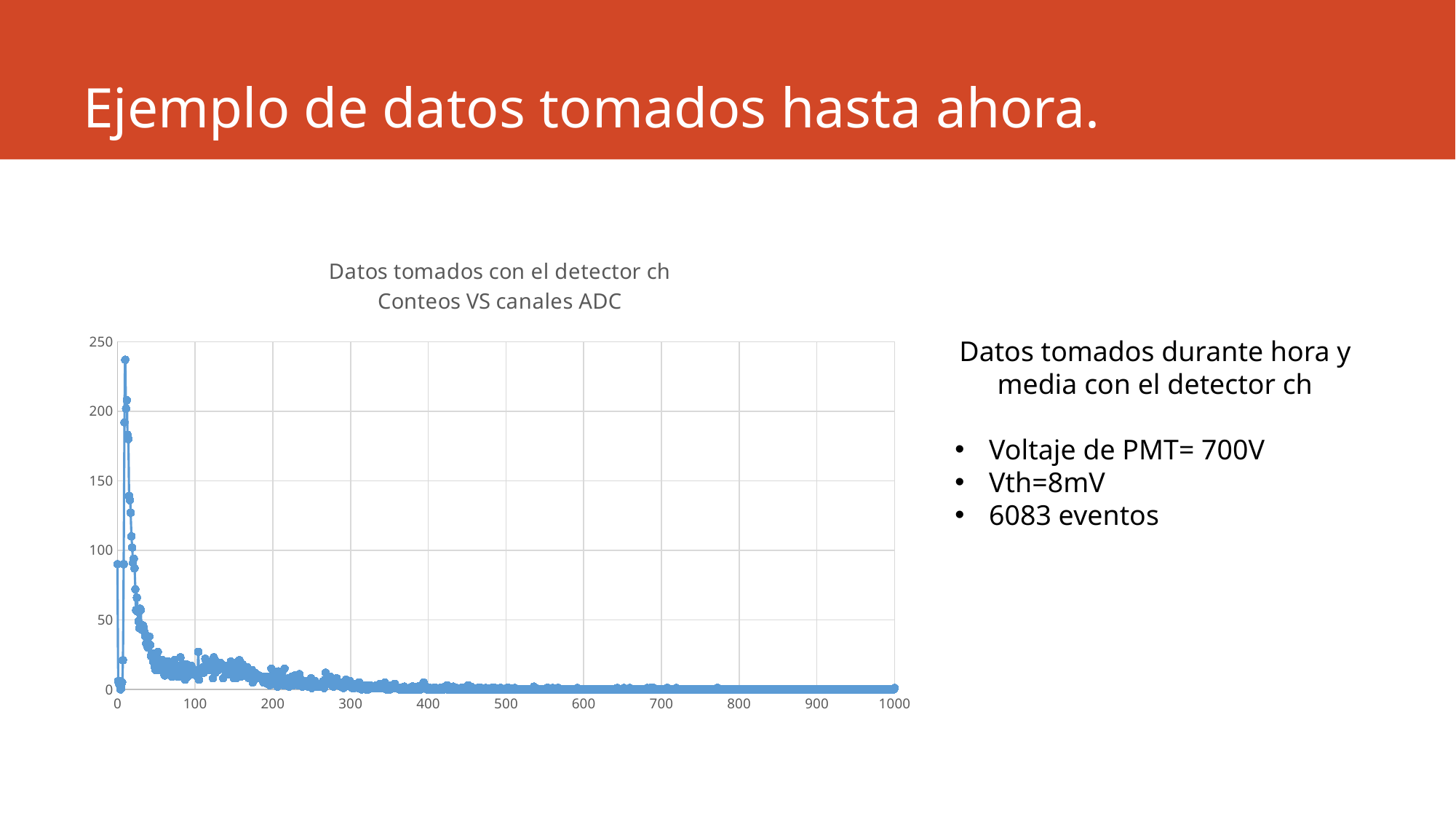
Are the plotted values near x = 500 greater or less than 50? less What is the title of the chart? Datos tomados con el detector ch Conteos VS canales ADC Is the highest plotted value in the chart greater or less than 200? greater How many data series are plotted in the chart? 1 Is the highest plotted value in the chart greater or less than 250? less Overall, do the plotted values rise or fall as the x axis increases from 100 to 1000? fall What is the largest value shown on the x axis of the chart? 1000 What kind of chart is shown on the slide? scatter chart